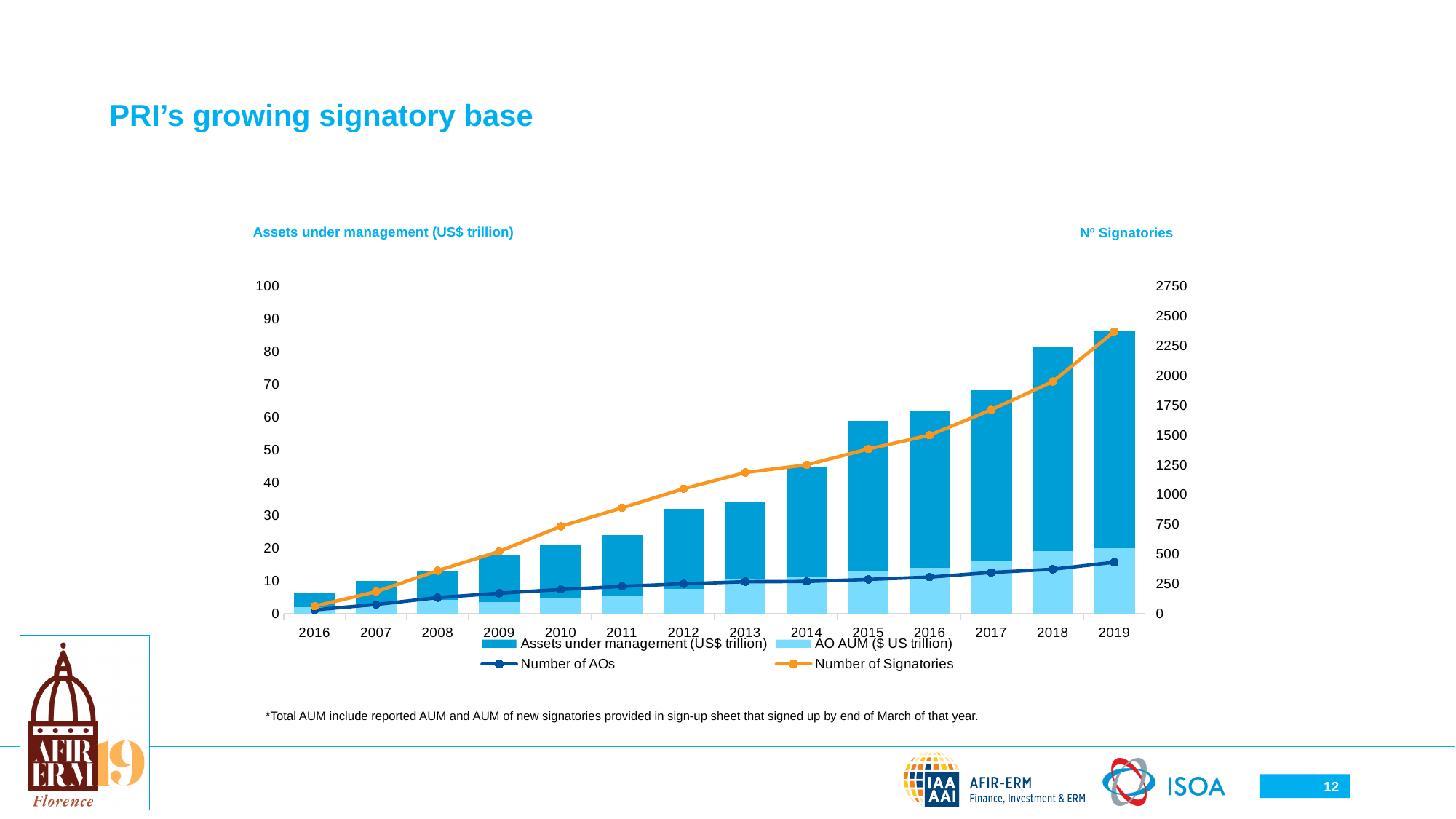
Is the Assets under management value for 2014 greater or less than 50? less What is the title of the right-hand vertical axis? Nº Signatories In which year is the Assets under management bar the highest? 2019 Is the Number of AOs for 2019 greater or less than 500? less Is the Number of Signatories for 2019 greater or less than 2250? greater How many years are shown along the x axis? 14 How many series does the legend list? 4 Which year has the highest Number of Signatories? 2019 What kind of chart is this? Combination bar and line chart Do the Number of Signatories values rise or fall from left to right along the x axis? Rise Which is larger, the Assets under management bar for 2015 or for 2012? 2015